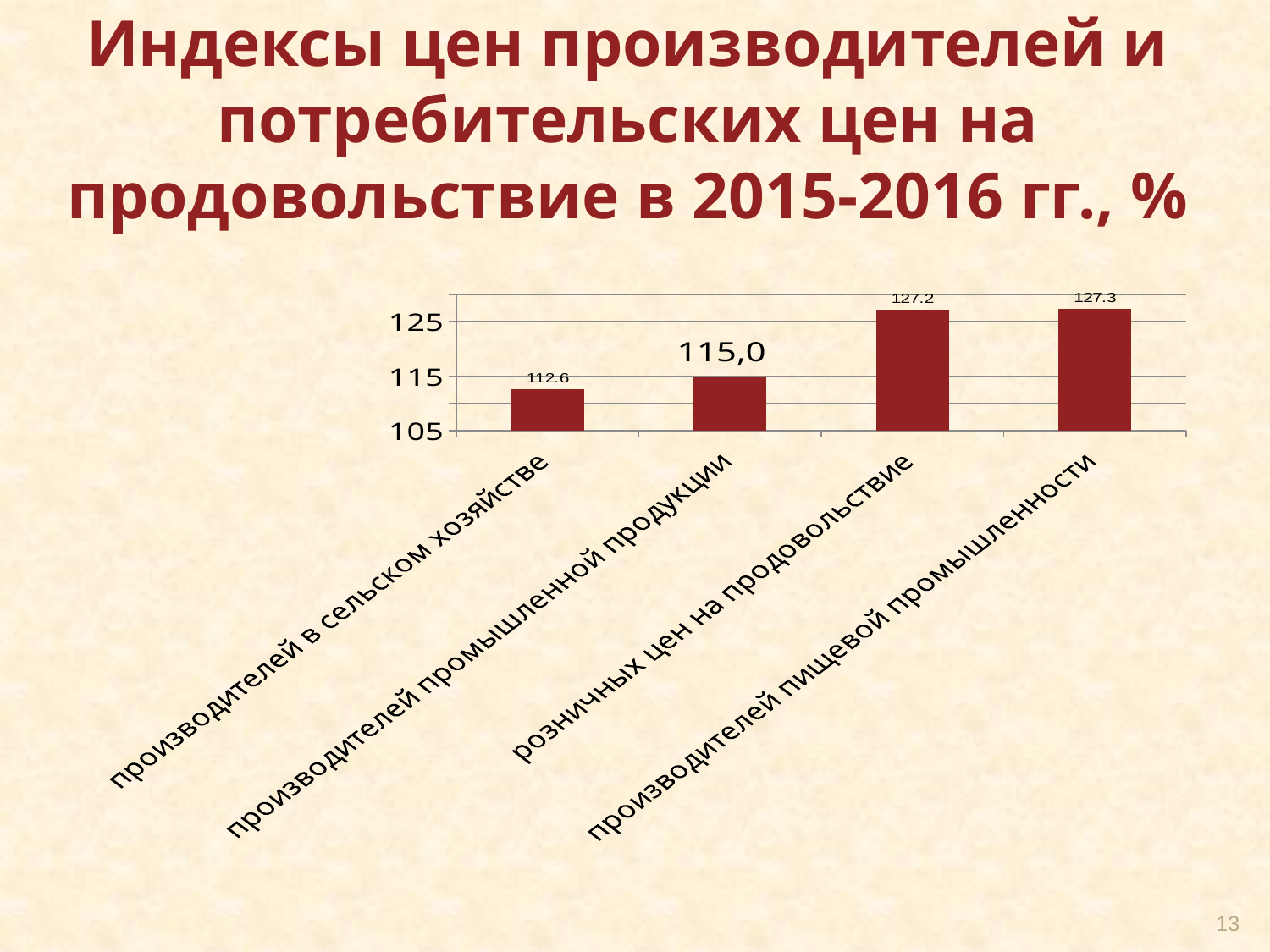
What is the value for розничных цен на продовольствие? 127.2 Which category has the highest value according to the data labels? производителей пищевой промышленности Is the value for производителей в сельском хозяйстве greater or less than 115? less What kind of chart is shown on the slide? bar chart Which category has the lowest value? производителей в сельском хозяйстве Which is larger, the value for розничных цен на продовольствие or the value for производителей промышленной продукции? розничных цен на продовольствие How many categories are shown in the chart? 4 What is the value for производителей промышленной продукции? 115,0 What is the difference between the values for производителей промышленной продукции and производителей в сельском хозяйстве? 2.4 What is the difference between the values for розничных цен на продовольствие and производителей в сельском хозяйстве? 14.6 What is the value for производителей в сельском хозяйстве? 112.6 What is the value for производителей пищевой промышленности? 127.3